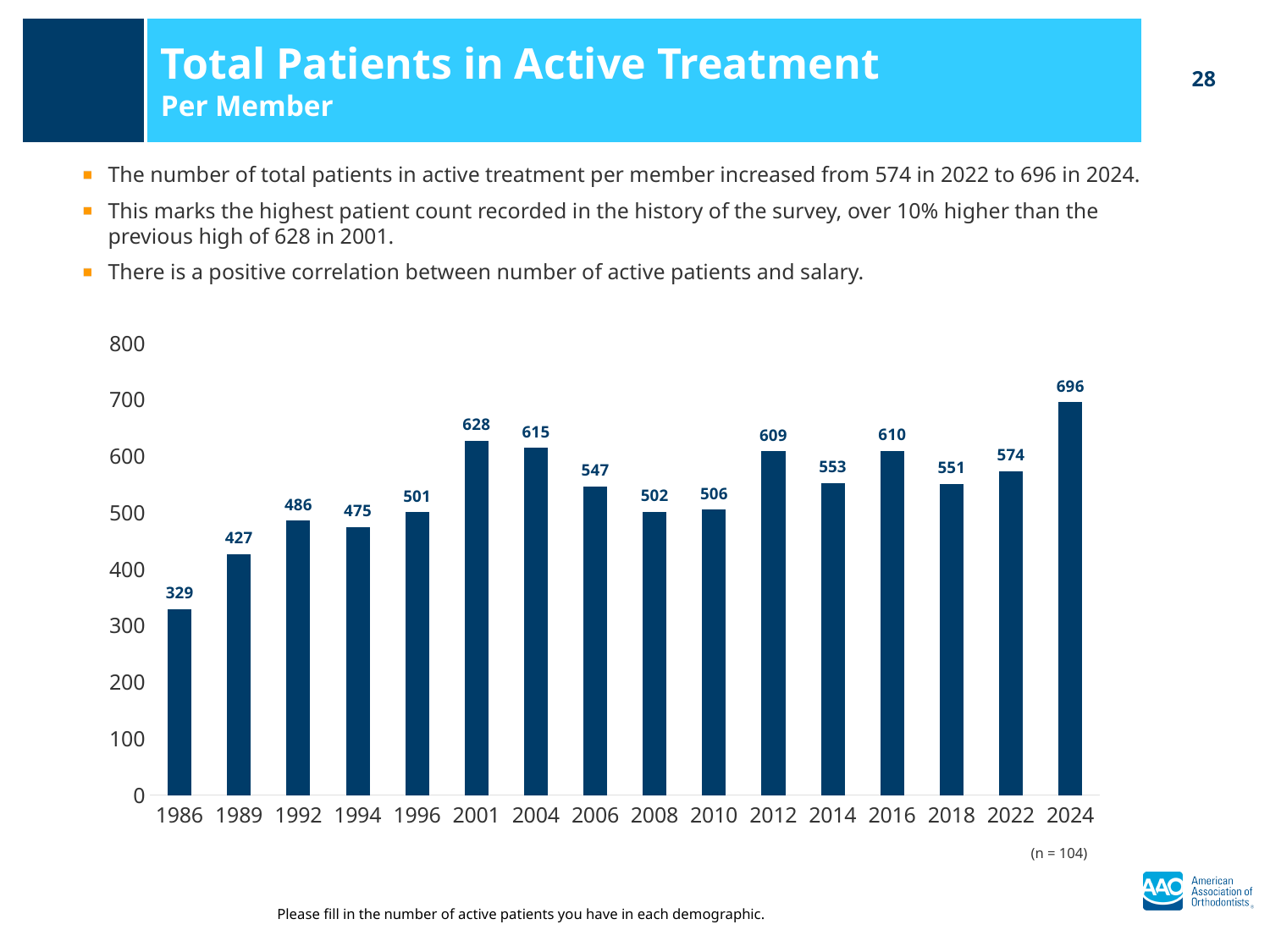
What is the value for 2024? 696 What is the difference between the values for 2024 and 2022? 122 What is the title of the slide containing the chart? Total Patients in Active Treatment Per Member Which is larger, the value for 2012 or the value for 2016? 2016 What kind of chart is shown on the slide? bar chart What is the value for 2001? 628 Which year has the highest value? 2024 What is the value for 1986? 329 How many years are shown on the x axis? 16 Is the value for 2006 greater or less than 500? greater Which year has the lowest value? 1986 Do the values rise or fall from 2022 to 2024? rise